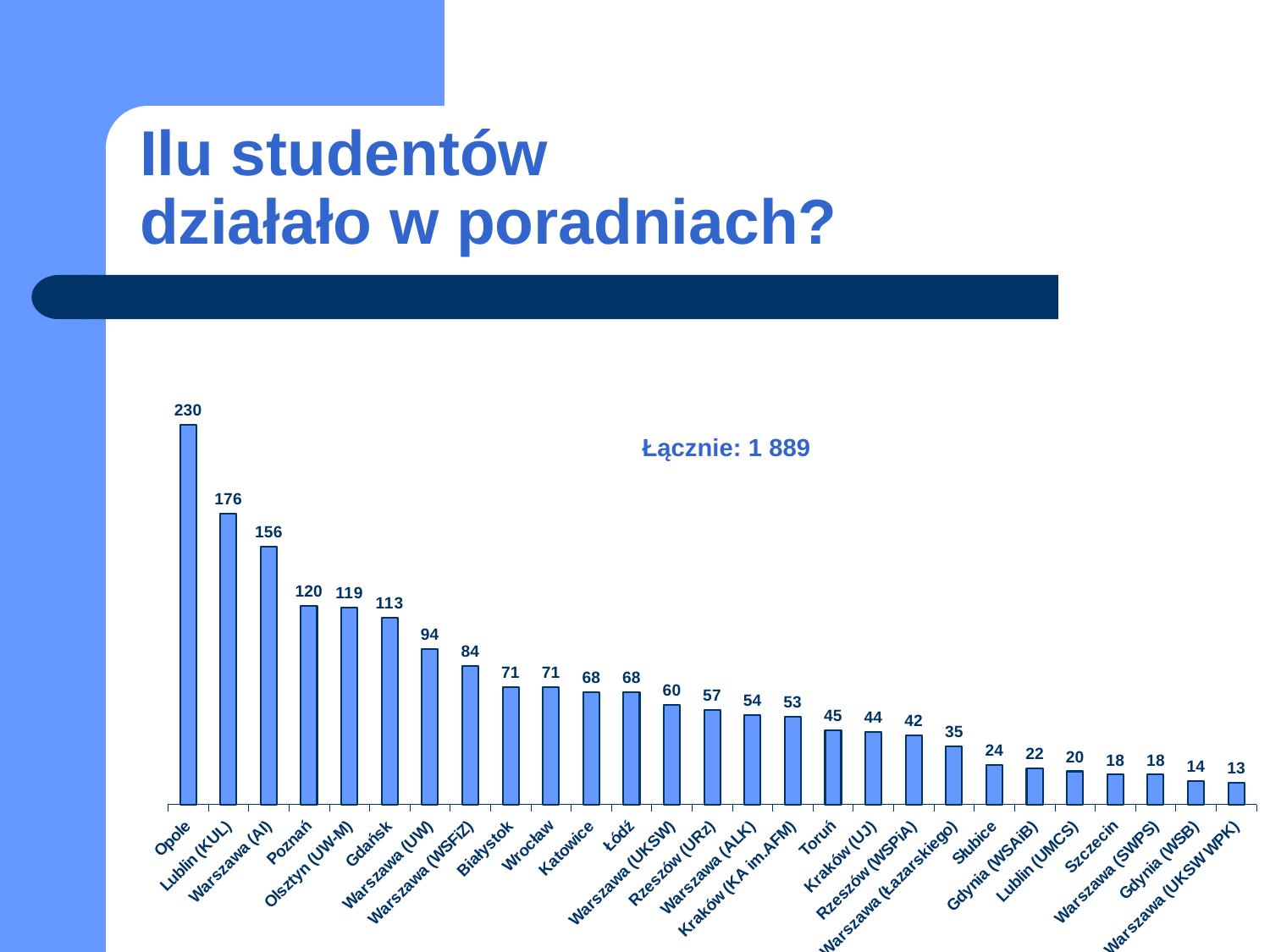
How many students are shown for Opole? 230 What kind of chart is shown on the slide? Bar chart Which category has the lowest value? Warszawa (UKSW WPK) What is the difference between the values for Poznań and Toruń? 75 Which category has the highest value? Opole Do the values rise or fall from left to right along the x axis? Fall Which is larger, the value for Warszawa (UW) or the value for Warszawa (WSFiZ)? Warszawa (UW) What is the value for Gdańsk? 113 How many categories are plotted on the chart? 27 What total is printed on the chart after 'Łącznie'? 1 889 What is the value for Kraków (UJ)? 44 What is the difference between the values for Opole and Lublin (KUL)? 54